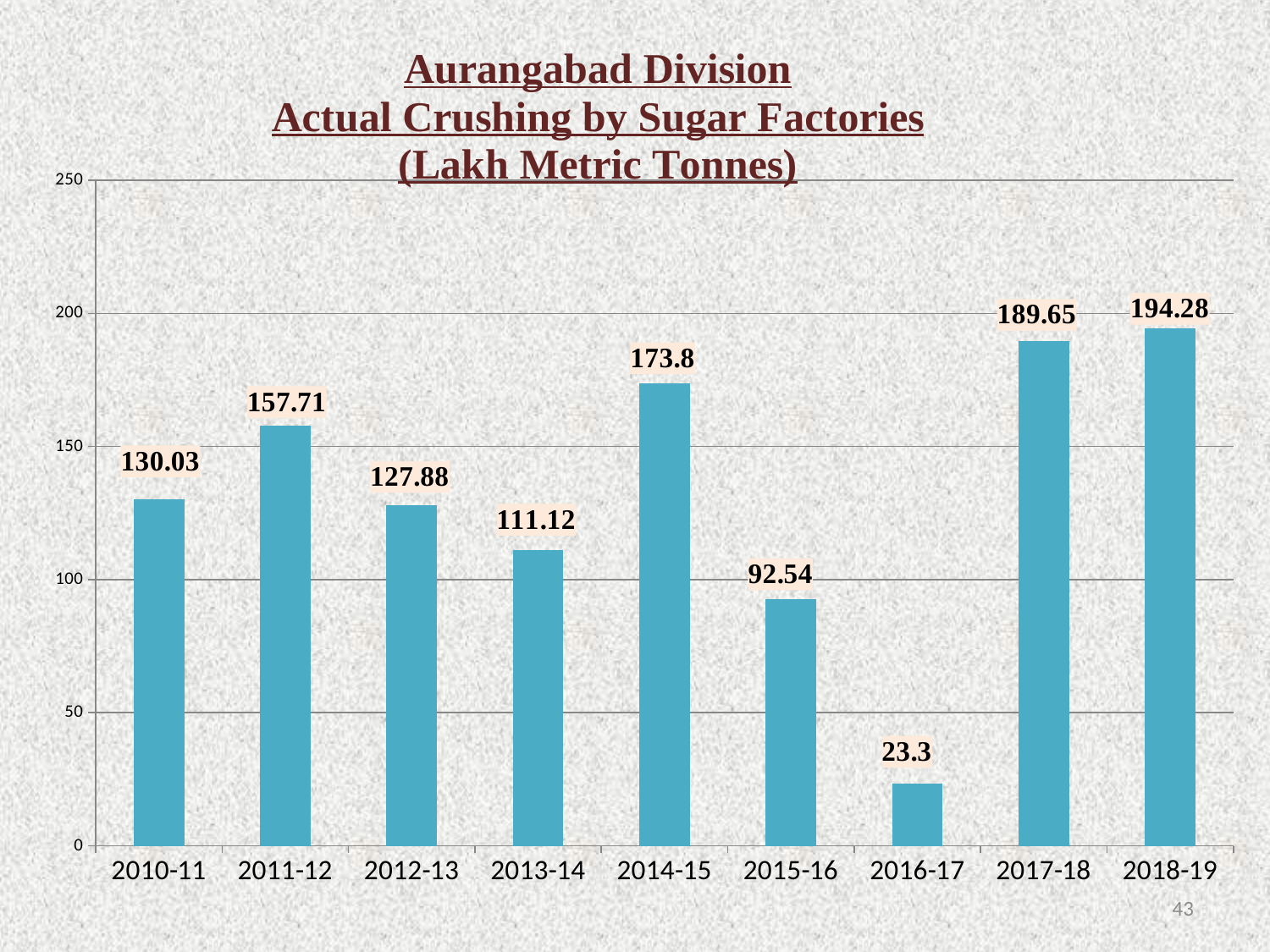
Which year has the highest actual crushing value? 2018-19 What is the actual crushing value for 2016-17? 23.3 Which year has the lowest actual crushing value? 2016-17 What is the difference between the values for 2018-19 and 2017-18? 4.63 Which is larger, the value for 2013-14 or the value for 2015-16? 2013-14 What is the actual crushing value for 2014-15? 173.8 What unit is given in the chart title? Lakh Metric Tonnes What is the difference between the values for 2011-12 and 2012-13? 29.83 Is the value for 2017-18 greater or less than 200? less What is the actual crushing value for 2010-11? 130.03 How many years are shown on the x axis? 9 What kind of chart is shown on the slide? bar chart